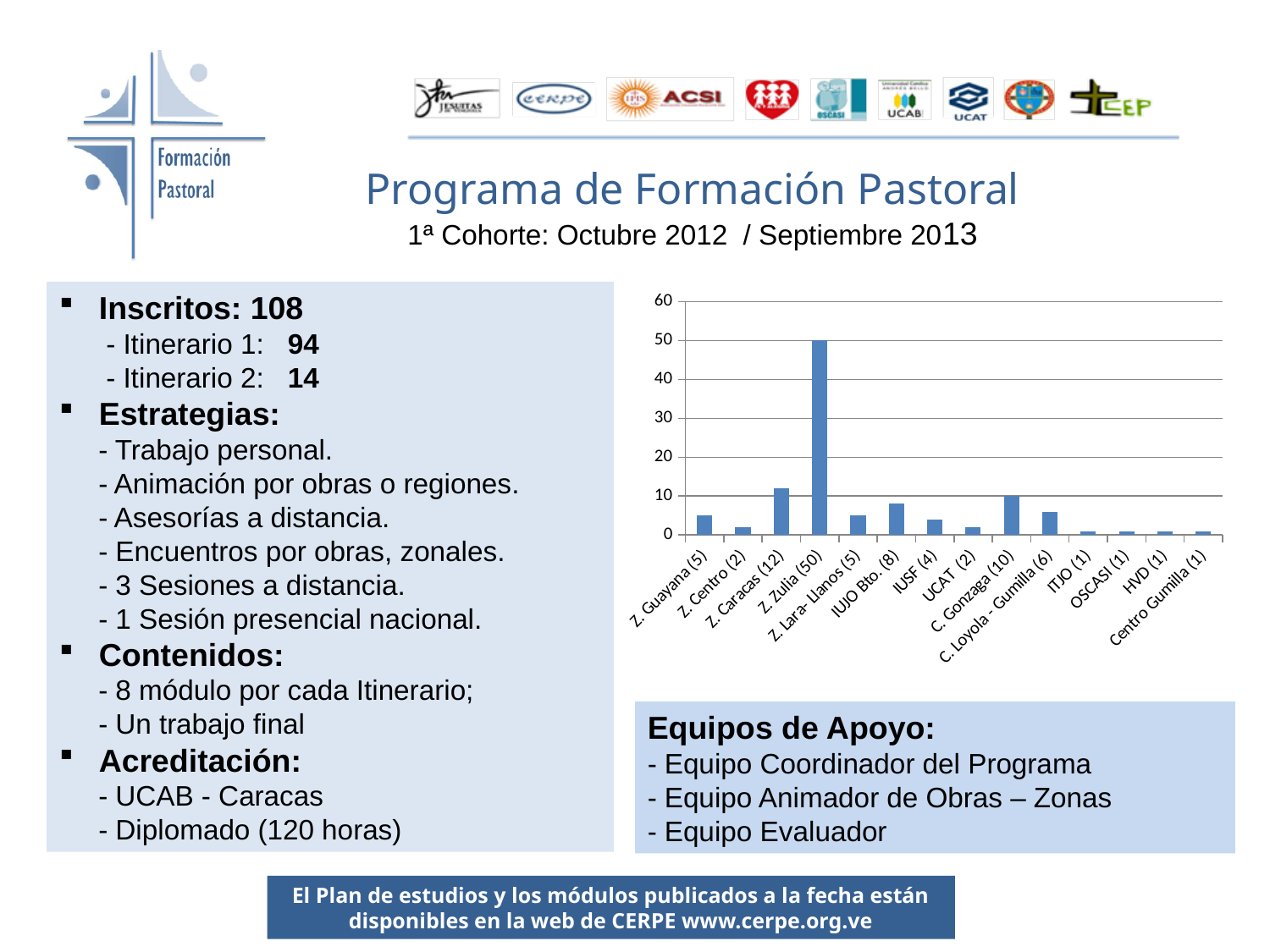
What is the value for C. Gonzaga in the bar chart? 10 How many categories are plotted in the bar chart? 14 What kind of chart is shown on the slide? bar chart What is the value for IUJO Bto. in the bar chart? 8 Is the value for Z. Zulia greater or less than 40? greater What is the difference between the values for Z. Zulia and Z. Caracas? 38 What is the value for Z. Caracas in the bar chart? 12 What is the highest value shown on the vertical axis of the bar chart? 60 Which is larger, the value for C. Gonzaga or the value for C. Loyola - Gumilla? C. Gonzaga What is the value for Z. Zulia in the bar chart? 50 Is the value for Z. Guayana greater or less than 10? less Which category has the highest value in the bar chart? Z. Zulia